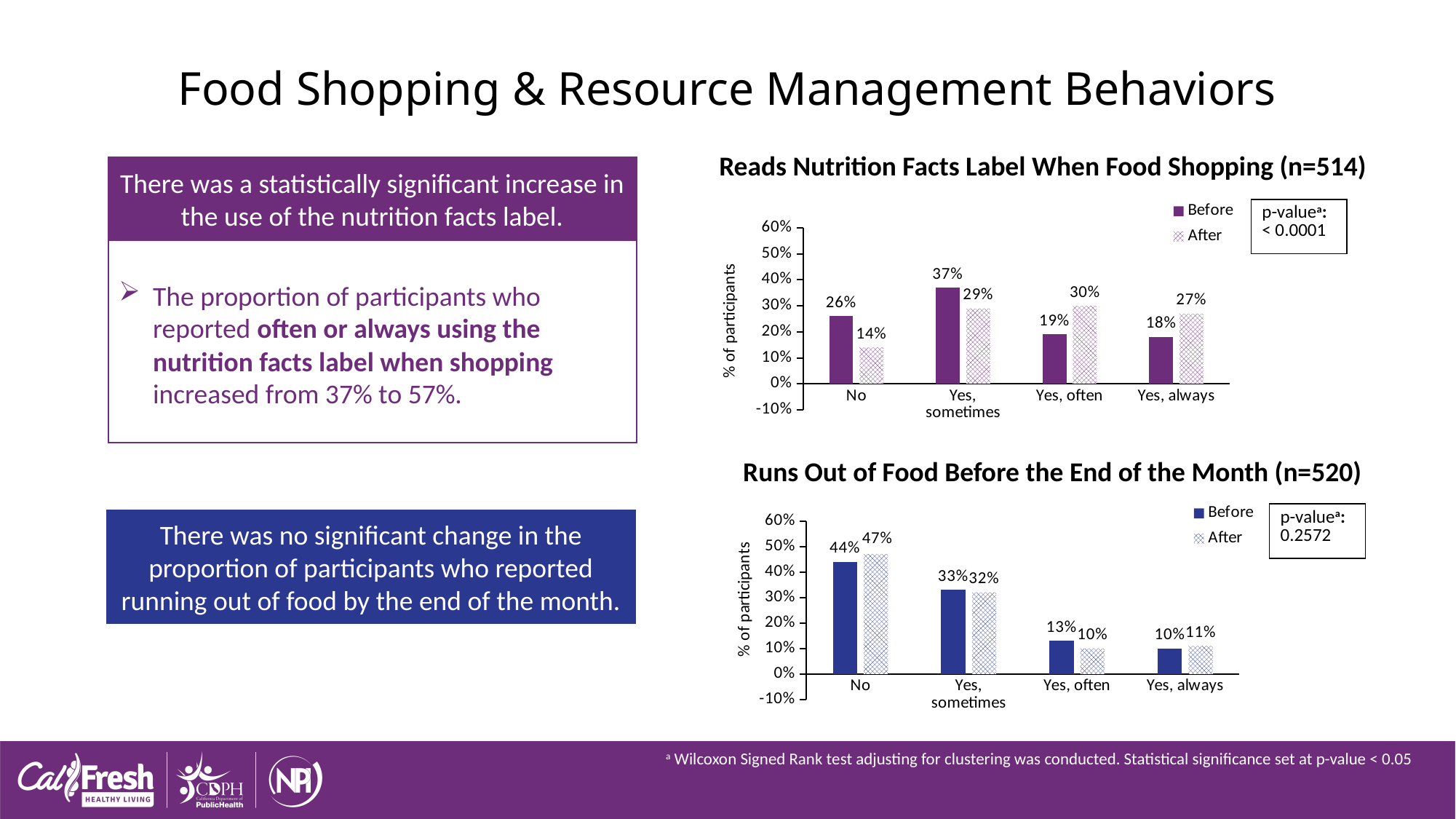
In the 'Runs Out of Food Before the End of the Month' chart, what is the Before value for 'Yes, often'? 13% What kind of chart is the 'Runs Out of Food Before the End of the Month' chart? Bar chart In the 'Reads Nutrition Facts Label When Food Shopping' chart, what is the After value for 'No'? 14% In the 'Reads Nutrition Facts Label When Food Shopping' chart, what is the difference between the Before and After values for 'No'? 12% How many categories are shown on the x axis of the 'Runs Out of Food Before the End of the Month' chart? 4 In the 'Reads Nutrition Facts Label When Food Shopping' chart, what is the Before value for 'Yes, sometimes'? 37% In the 'Runs Out of Food Before the End of the Month' chart, what is the After value for 'No'? 47% In the 'Reads Nutrition Facts Label When Food Shopping' chart, is the Before or After value larger for 'Yes, always'? After How many series does the legend of the 'Reads Nutrition Facts Label When Food Shopping' chart list? 2 In the 'Reads Nutrition Facts Label When Food Shopping' chart, which category has the highest After value? Yes, often In the 'Runs Out of Food Before the End of the Month' chart, which category has the lowest Before value? Yes, always In the 'Runs Out of Food Before the End of the Month' chart, what is the difference between the Before and After values for 'Yes, often'? 3%